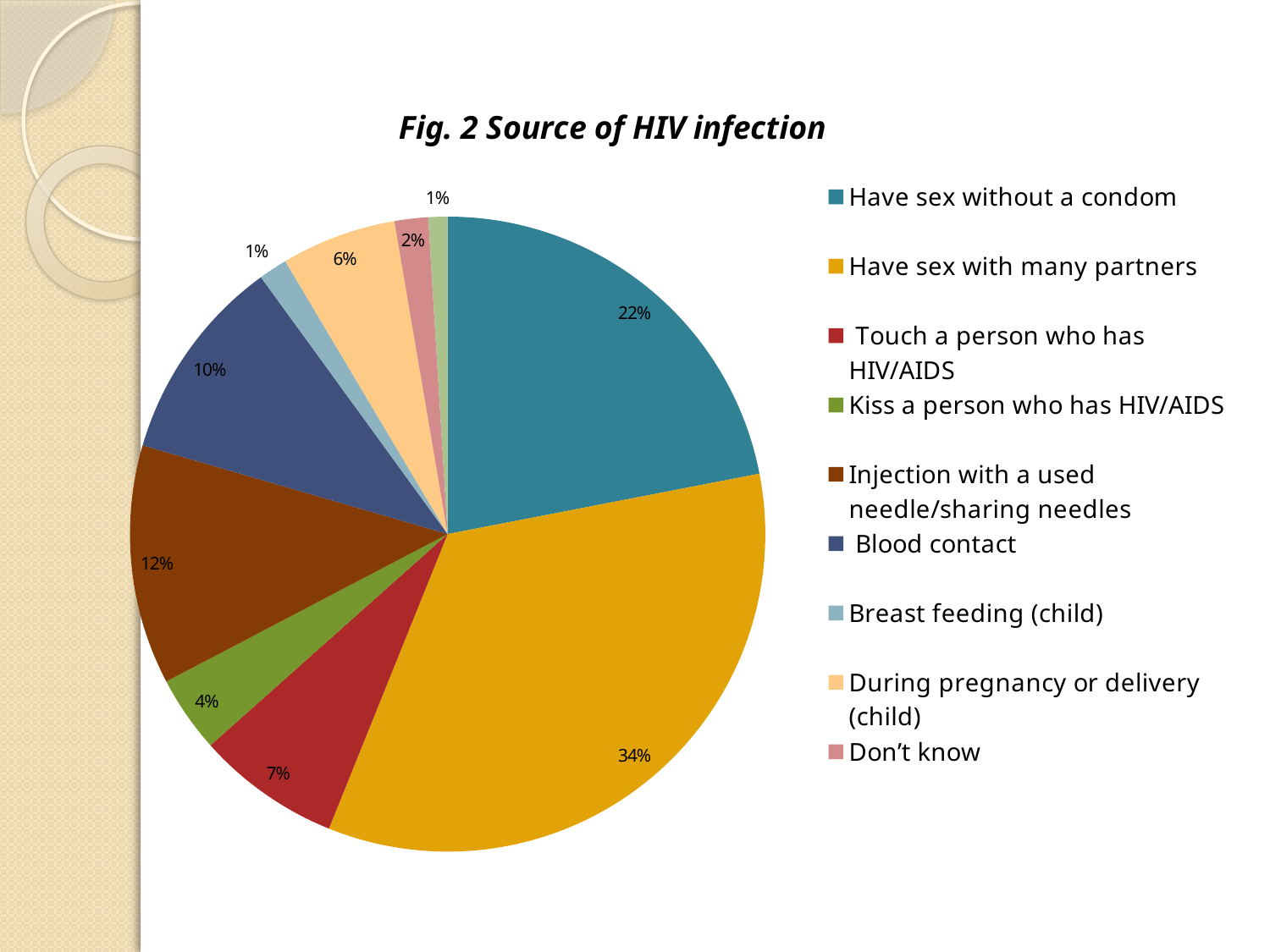
Which category has the largest share of the pie? Have sex with many partners What percentage is shown for 'Injection with a used needle/sharing needles'? 12% Which is larger: the share for 'Blood contact' or for 'Injection with a used needle/sharing needles'? Injection with a used needle/sharing needles What is the title of the chart? Fig. 2 Source of HIV infection What type of chart is shown on the slide? Pie chart What percentage is shown for 'During pregnancy or delivery (child)'? 6% What percentage is shown for 'Touch a person who has HIV/AIDS'? 7% What percentage is shown for 'Have sex with many partners'? 34% What percentage is shown for 'Have sex without a condom'? 22% What percentage is shown for 'Blood contact'? 10% What is the difference in percentage points between 'Have sex with many partners' and 'Have sex without a condom'? 12 How many entries does the legend list? 9